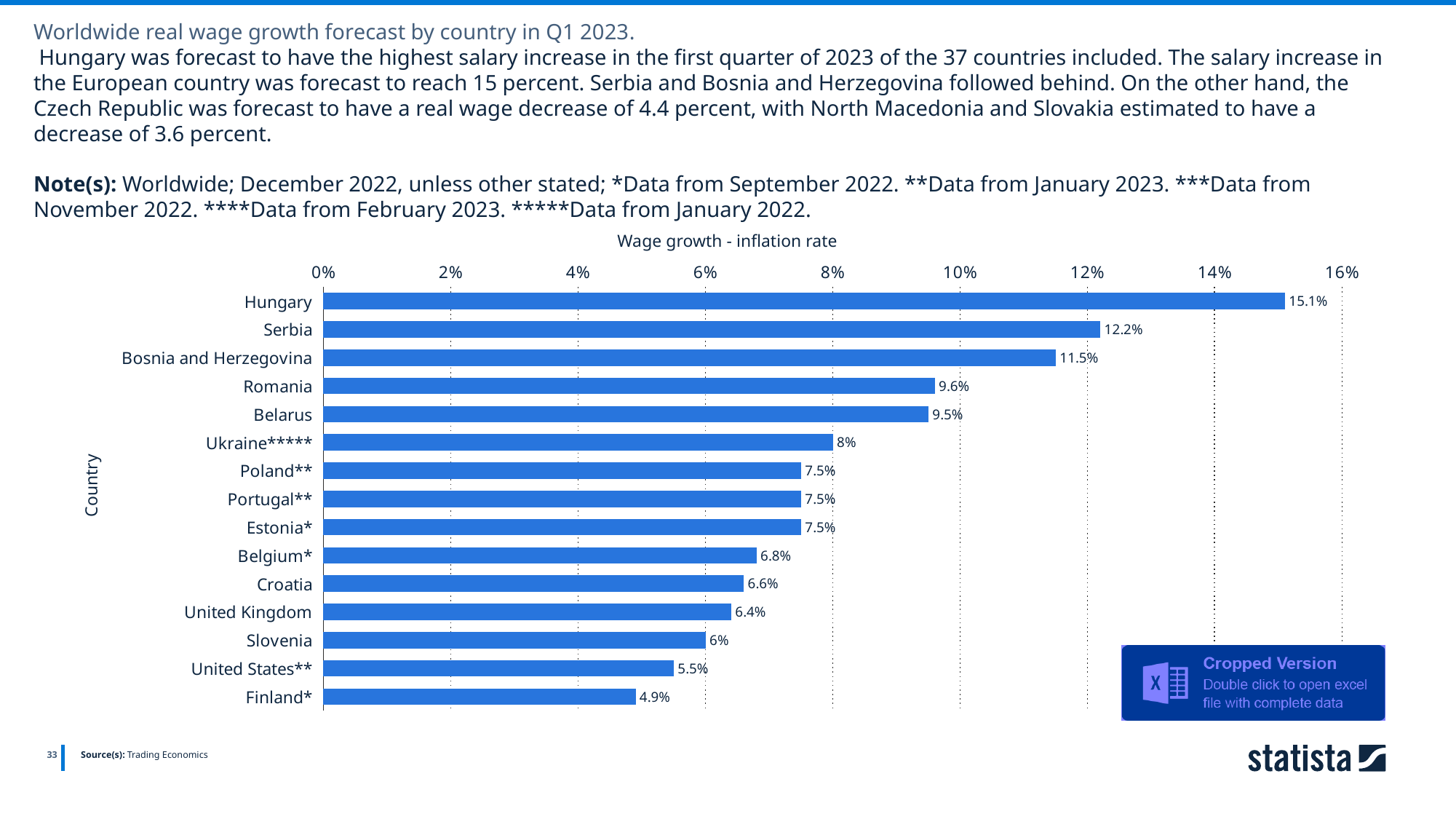
What is the forecast real wage growth for Hungary? 15.1% What is the title of the chart's horizontal axis? Wage growth - inflation rate What type of chart is shown on the slide? Bar chart What is the value shown for the United Kingdom? 6.4% What is the value shown for Bosnia and Herzegovina? 11.5% Which country has the lowest value in the chart? Finland* How many countries are shown in the chart? 15 Which country has the highest value in the chart? Hungary What is the difference between the values for Hungary and Serbia? 2.9% Which has a larger value, Belgium* or Croatia? Belgium* What is the difference between the values for the United States** and Finland*? 0.6% What is the value shown for Serbia? 12.2%